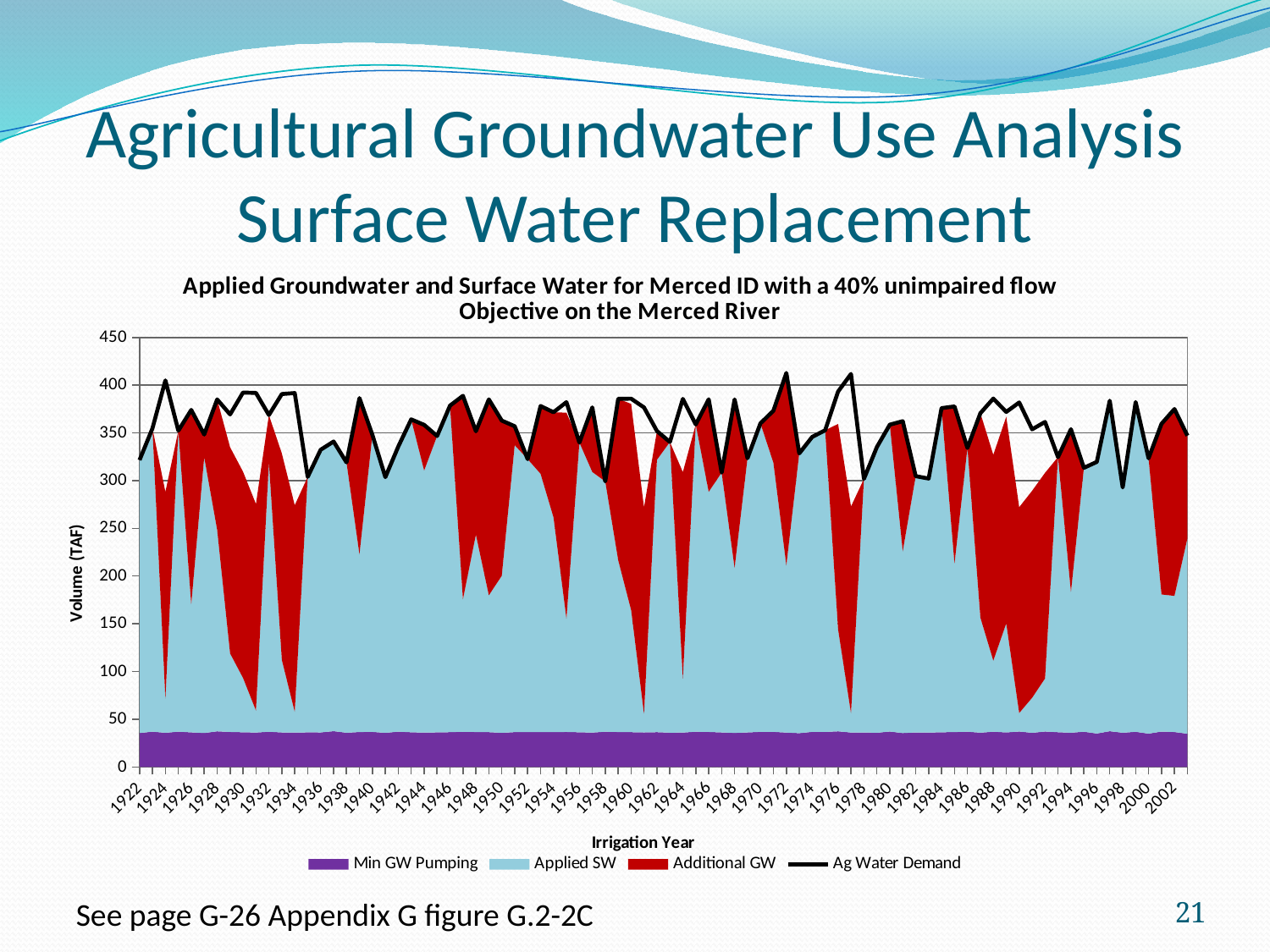
What is the title of the chart? Applied Groundwater and Surface Water for Merced ID with a 40% unimpaired flow Objective on the Merced River Is the Ag Water Demand value in 1930 greater or less than 350? greater Is the Min GW Pumping value in 1950 greater or less than 50? less What is the highest value shown on the y axis? 450 Is the Ag Water Demand value in 1922 greater or less than 300? greater What kind of chart is shown on the slide? Combination area and line chart Which is larger, the Ag Water Demand in 1924 or in 1935? 1924 How many series does the legend list? 4 Which series is shown in red in the chart? Additional GW